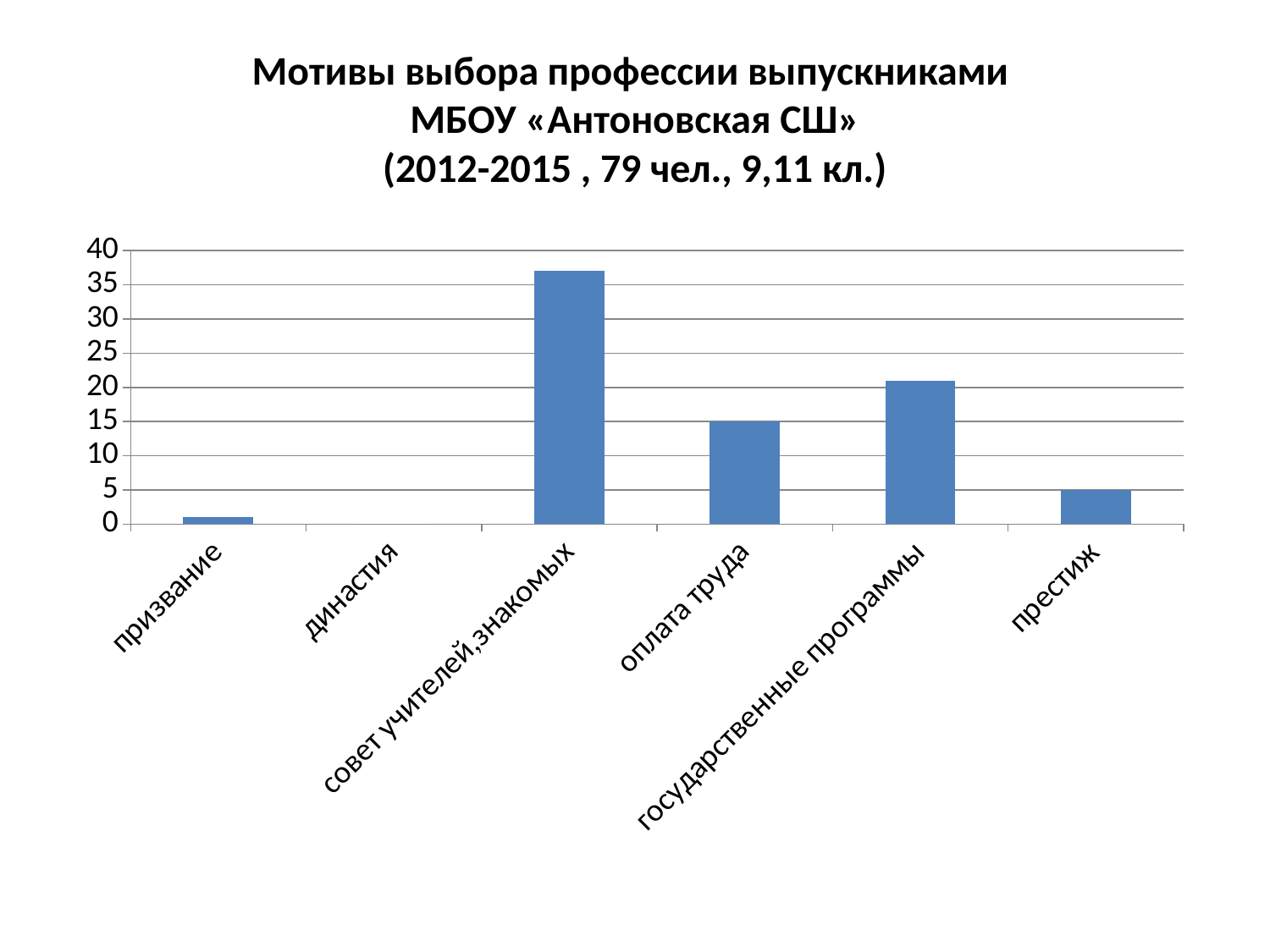
Is the value for государственные программы greater or less than 25? less Which category has the lowest value in the chart? династия How many categories are shown on the x axis of the chart? 6 Which is larger: the value for государственные программы or the value for оплата труда? государственные программы What is the first line of the chart's title? Мотивы выбора профессии выпускниками Is the value for совет учителей,знакомых greater or less than 35? greater What is the difference between the values for оплата труда and престиж? 10 What kind of chart is shown on the slide? bar chart What is the value for престиж? 5 What is the value for оплата труда? 15 Which category has the highest value in the chart? совет учителей,знакомых Is the value for призвание greater or less than 5? less